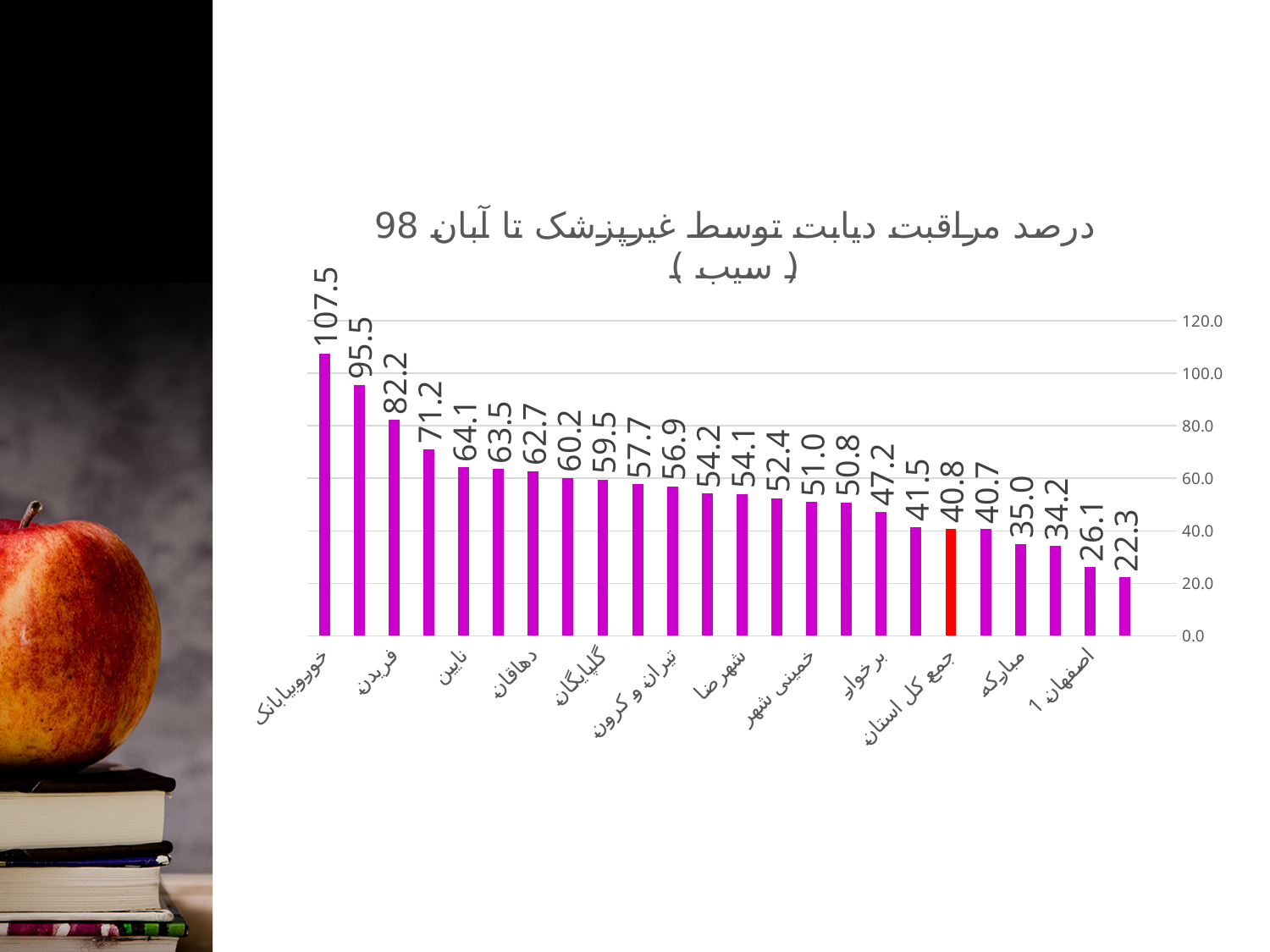
What kind of chart is shown? Bar chart What is the value for مبارکه? 35.0 Which category's bar is coloured red instead of magenta? جمع کل استان What is the value for جمع کل استان? 40.8 What is the value for خوروبیابانک? 107.5 What is the value for فریدن? 82.2 What is the value for اصفهان 1? 26.1 Which is larger, the value for نایین or the value for دهاقان? نایین How many bars are plotted on the chart? 24 Which category has the highest value? خوروبیابانک What is the lowest value shown on the chart? 22.3 What is the difference between the values for خوروبیابانک and فریدن? 25.3